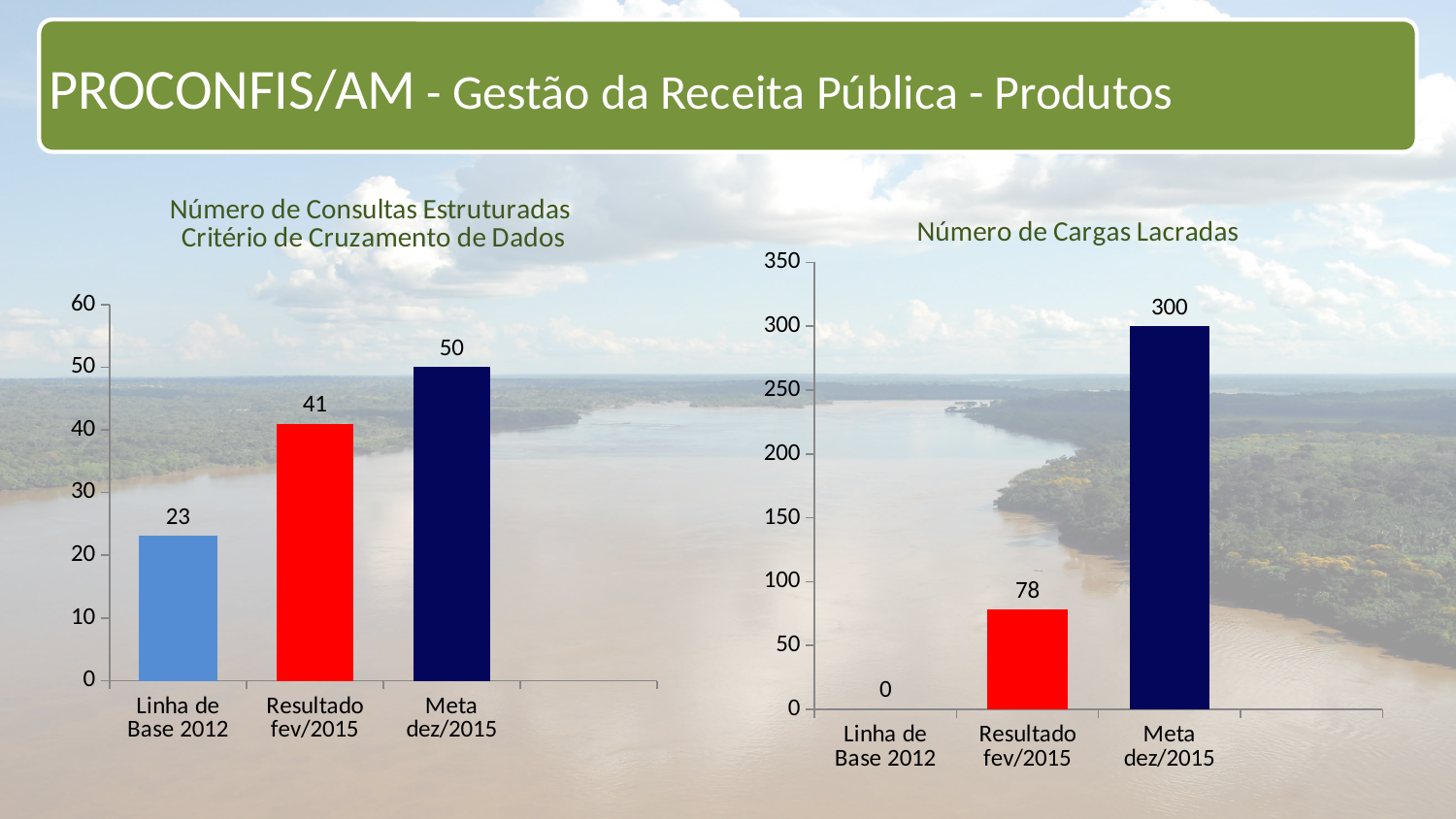
In the 'Número de Cargas Lacradas' chart, what is the difference between Meta dez/2015 and Resultado fev/2015? 222 How many categories are shown in the 'Número de Consultas Estruturadas Critério de Cruzamento de Dados' chart? 3 In the 'Número de Consultas Estruturadas Critério de Cruzamento de Dados' chart, what is the value for Linha de Base 2012? 23 In the 'Número de Cargas Lacradas' chart, what is the value for Meta dez/2015? 300 In the 'Número de Consultas Estruturadas Critério de Cruzamento de Dados' chart, which category has the highest value? Meta dez/2015 In the 'Número de Consultas Estruturadas Critério de Cruzamento de Dados' chart, do the values rise or fall from Linha de Base 2012 to Meta dez/2015? Rise In the 'Número de Cargas Lacradas' chart, which category has the lowest value? Linha de Base 2012 What type of chart is the 'Número de Cargas Lacradas' chart? Bar chart In the 'Número de Cargas Lacradas' chart, which is larger: Resultado fev/2015 or Meta dez/2015? Meta dez/2015 In the 'Número de Consultas Estruturadas Critério de Cruzamento de Dados' chart, what is the difference between Meta dez/2015 and Resultado fev/2015? 9 In the 'Número de Consultas Estruturadas Critério de Cruzamento de Dados' chart, what is the value for Resultado fev/2015? 41 In the 'Número de Cargas Lacradas' chart, what is the value for Linha de Base 2012? 0